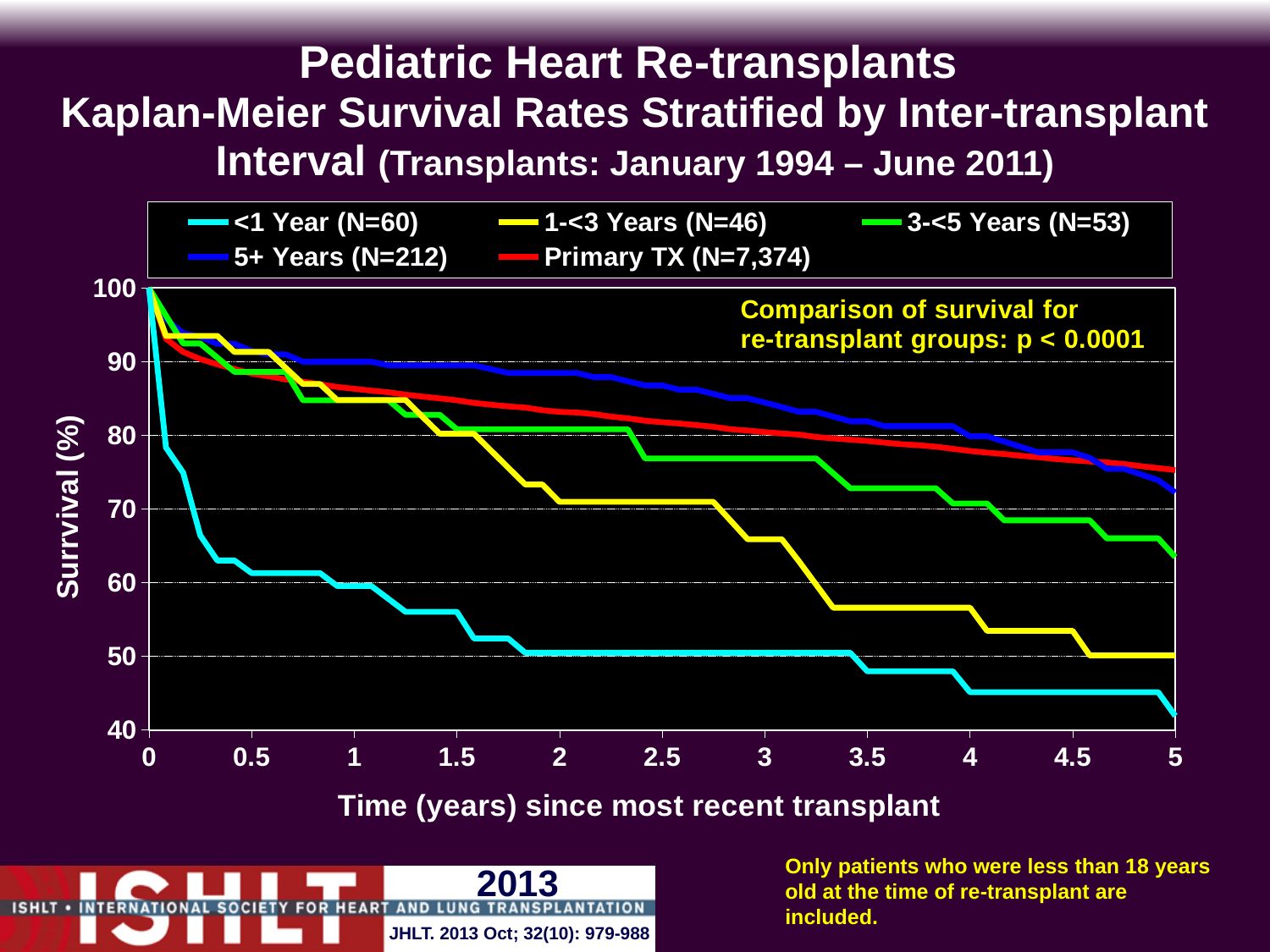
What is the N for the Primary TX group shown in the legend? 7,374 Is the survival for the <1 Year group at 4.5 years greater or less than 50? less What kind of chart is shown on the slide? line chart Is the survival for the 1-<3 Years group at 3.5 years greater or less than 60? less Which group has the highest survival at 3 years? 5+ Years (N=212) Which inter-transplant interval group has the lowest survival at 5 years? <1 Year (N=60) Is the survival for the 5+ Years group at 2 years greater or less than 90? less What is the survival value for all groups at time 0? 100 How many series does the legend list? 5 Do the survival curves rise or fall as time since transplant increases? fall At 5 years, which group has higher survival: 3-<5 Years or 1-<3 Years? 3-<5 Years What p-value is reported for the comparison of survival for re-transplant groups? p < 0.0001